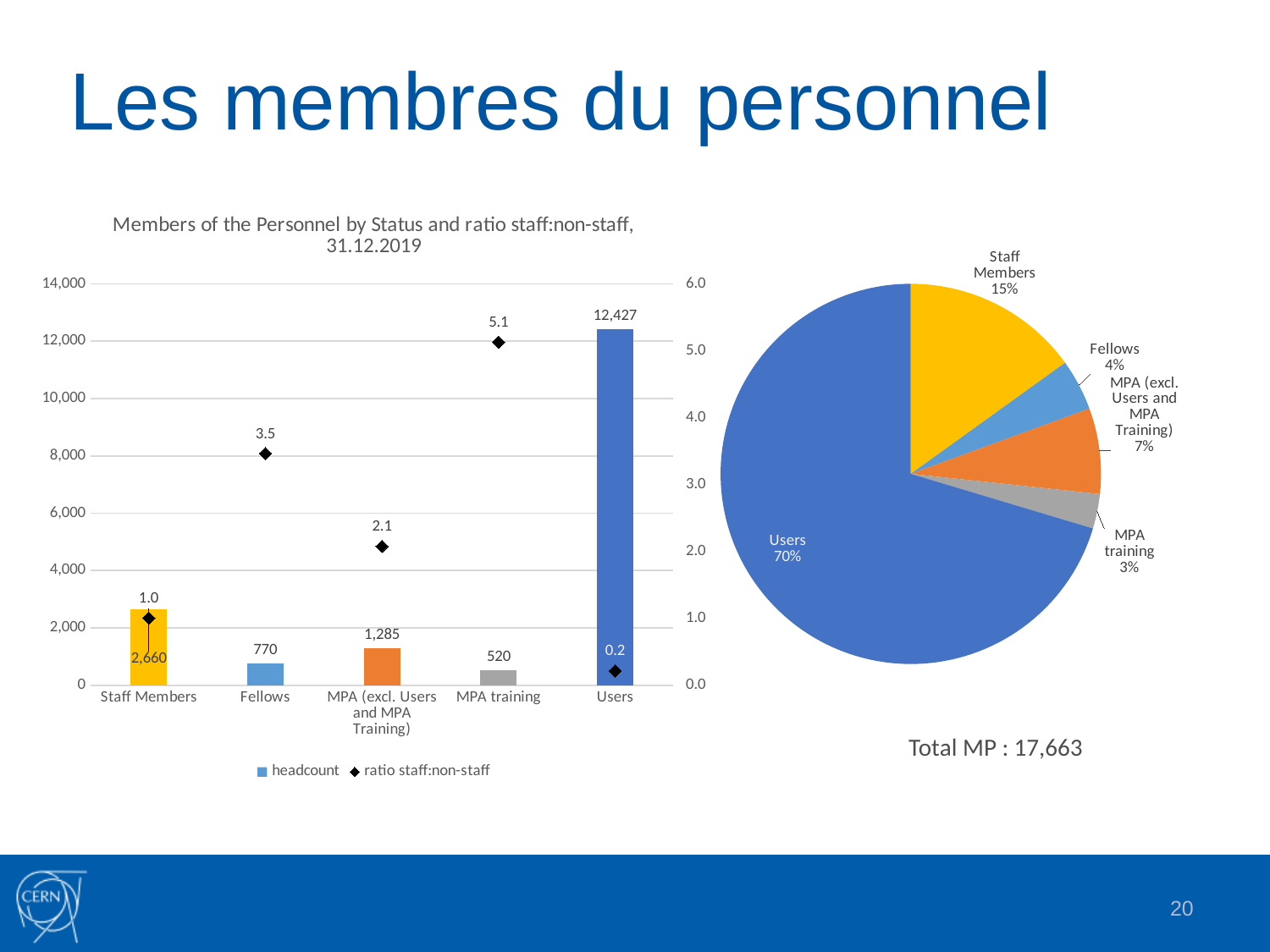
What kind of chart is shown on the right of the slide? Pie chart In the chart titled 'Members of the Personnel by Status and ratio staff:non-staff, 31.12.2019', what is the ratio staff:non-staff for Fellows? 3.5 In the pie chart on the right of the slide, what share do Users represent? 70% In the chart titled 'Members of the Personnel by Status and ratio staff:non-staff, 31.12.2019', what is the headcount for Users? 12,427 In the pie chart on the right of the slide, what share do Staff Members represent? 15% In the chart titled 'Members of the Personnel by Status and ratio staff:non-staff, 31.12.2019', which category has the highest ratio staff:non-staff? MPA training In the chart titled 'Members of the Personnel by Status and ratio staff:non-staff, 31.12.2019', which category has the lowest headcount? MPA training In the chart titled 'Members of the Personnel by Status and ratio staff:non-staff, 31.12.2019', how many categories are shown on the x axis? 5 In the chart titled 'Members of the Personnel by Status and ratio staff:non-staff, 31.12.2019', how many series does the legend list? 2 In the chart titled 'Members of the Personnel by Status and ratio staff:non-staff, 31.12.2019', what is the headcount for Staff Members? 2,660 In the chart titled 'Members of the Personnel by Status and ratio staff:non-staff, 31.12.2019', which has the larger headcount, Fellows or MPA (excl. Users and MPA Training)? MPA (excl. Users and MPA Training) In the chart titled 'Members of the Personnel by Status and ratio staff:non-staff, 31.12.2019', what is the difference in headcount between Staff Members and Fellows? 1,890